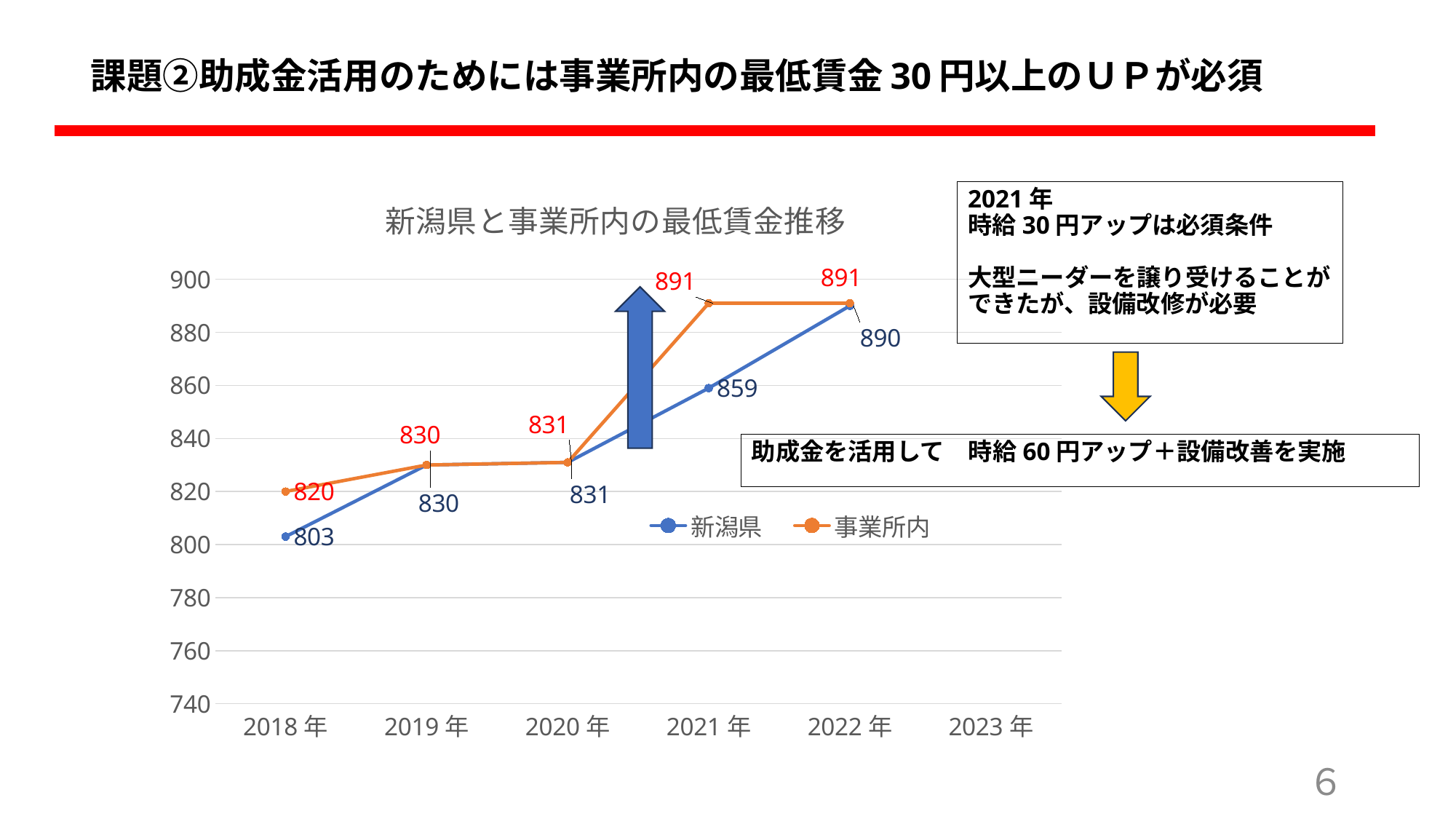
In which year is the 新潟県 value lowest? 2018年 What is the difference between 事業所内 and 新潟県 in 2021年? 32 Does the 新潟県 series rise or fall from 2018年 to 2022年? rise How many series does the legend list? 2 What is the value for 新潟県 in 2021年? 859 What is the value for 新潟県 in 2018年? 803 What is the title of the chart? 新潟県と事業所内の最低賃金推移 What is the value for 新潟県 in 2022年? 890 Which series has the higher value in 2018年, 新潟県 or 事業所内? 事業所内 What is the value for 事業所内 in 2018年? 820 What kind of chart is shown on the slide? line chart What is the value for 事業所内 in 2021年? 891